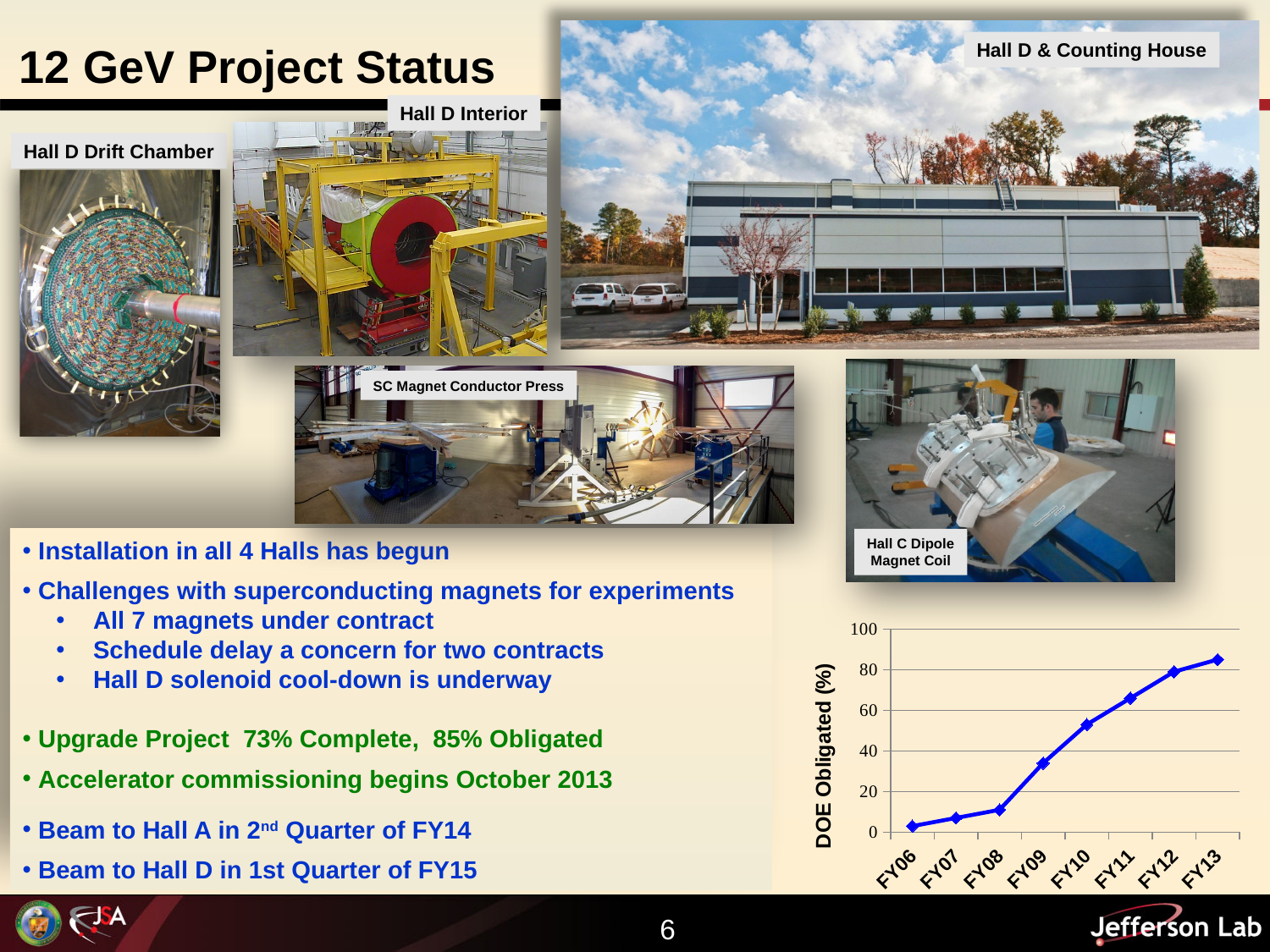
Is the DOE Obligated (%) value for FY08 greater or less than 20? less What kind of chart is shown at the bottom right of the slide? line chart Is the DOE Obligated (%) value for FY09 greater or less than 40? less Which fiscal year has the highest DOE Obligated (%) value? FY13 What is the label on the vertical axis of the chart? DOE Obligated (%) Is the DOE Obligated (%) value for FY13 greater or less than 80? greater Do the values on the DOE Obligated (%) chart rise or fall from FY06 to FY13? rise Which has a larger DOE Obligated (%) value, FY09 or FY10? FY10 How many fiscal years are plotted on the DOE Obligated (%) chart? 8 Which fiscal year has the lowest DOE Obligated (%) value? FY06